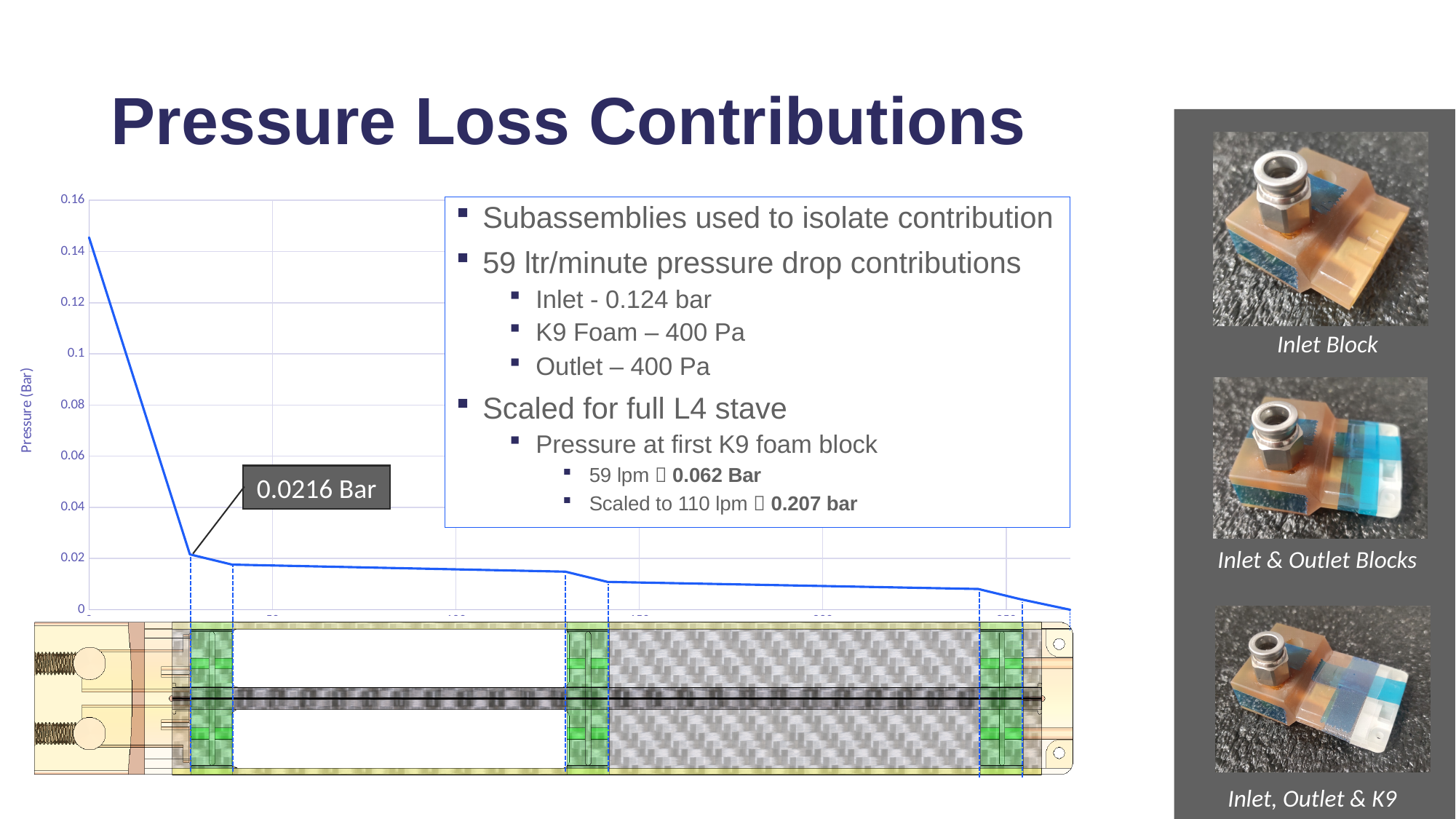
What is the highest tick value shown on the vertical axis of the chart? 0.16 Is the pressure value at the rightmost point of the line greater or less than 0.02? less Is the labelled value of 0.0216 Bar greater or less than 0.04? less Is the pressure value at the leftmost point of the line greater or less than 0.12? greater Do the plotted pressure values rise or fall moving left to right along the x axis? fall Which end of the line has the larger pressure value, the leftmost point or the rightmost point? leftmost point What kind of chart is shown on the slide? line chart What value is shown in the data label callout on the chart? 0.0216 Bar What is the title of the vertical axis of the chart? Pressure (Bar)